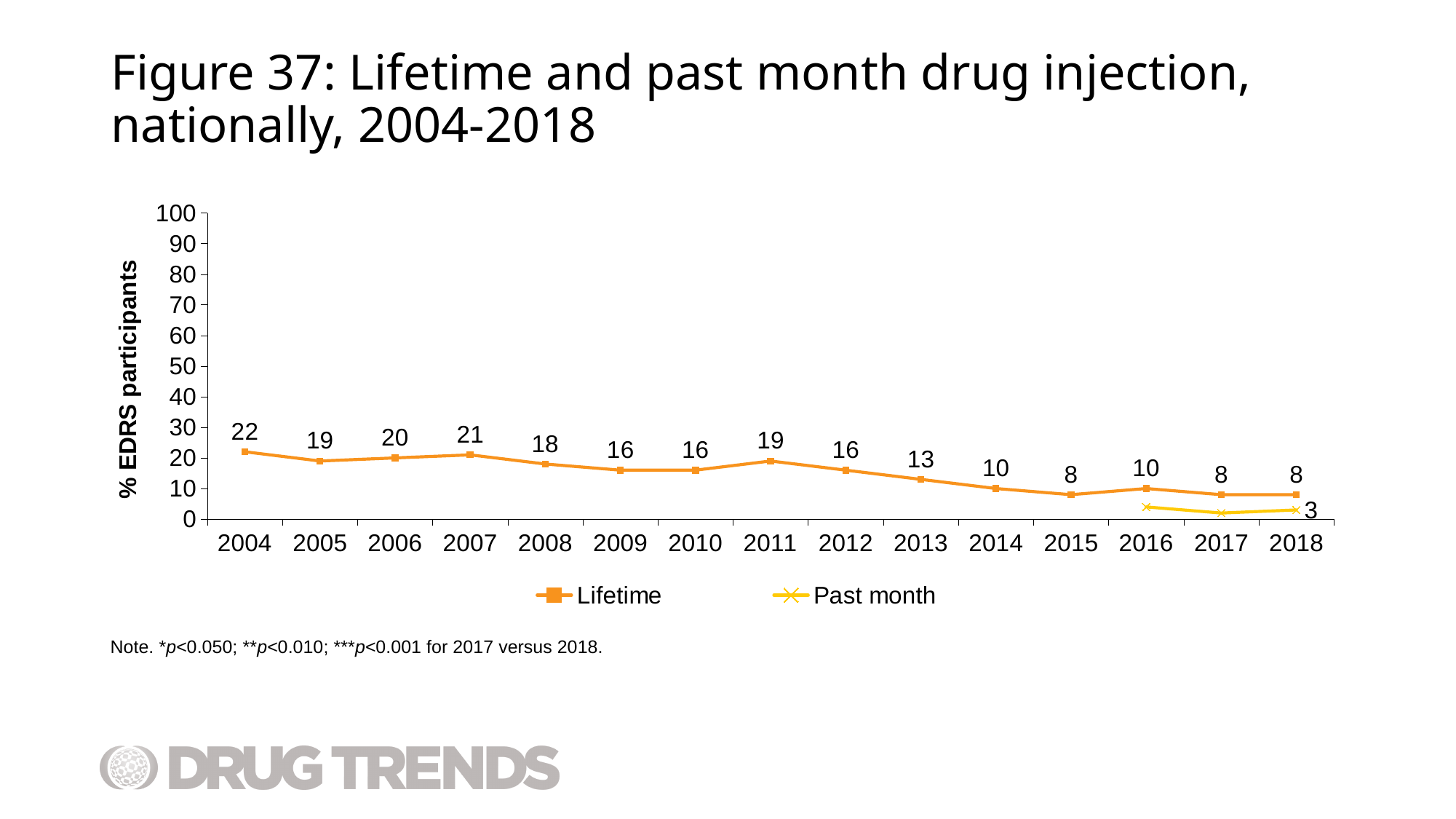
How many years are shown on the x axis? 15 In which year is the Lifetime series highest? 2004 What is the Past month value for 2018? 3 Which is larger, the Lifetime value for 2007 or for 2008? 2007 What is the lowest value reached by the Lifetime series? 8 What is the Lifetime value for 2011? 19 Does the Lifetime series generally rise or fall from 2004 to 2018? fall What is the difference between the Lifetime values for 2004 and 2018? 14 What kind of chart is this? line chart Is the Past month value for 2017 greater or less than 10? less How many series does the legend list? 2 What is the Lifetime value for 2004? 22